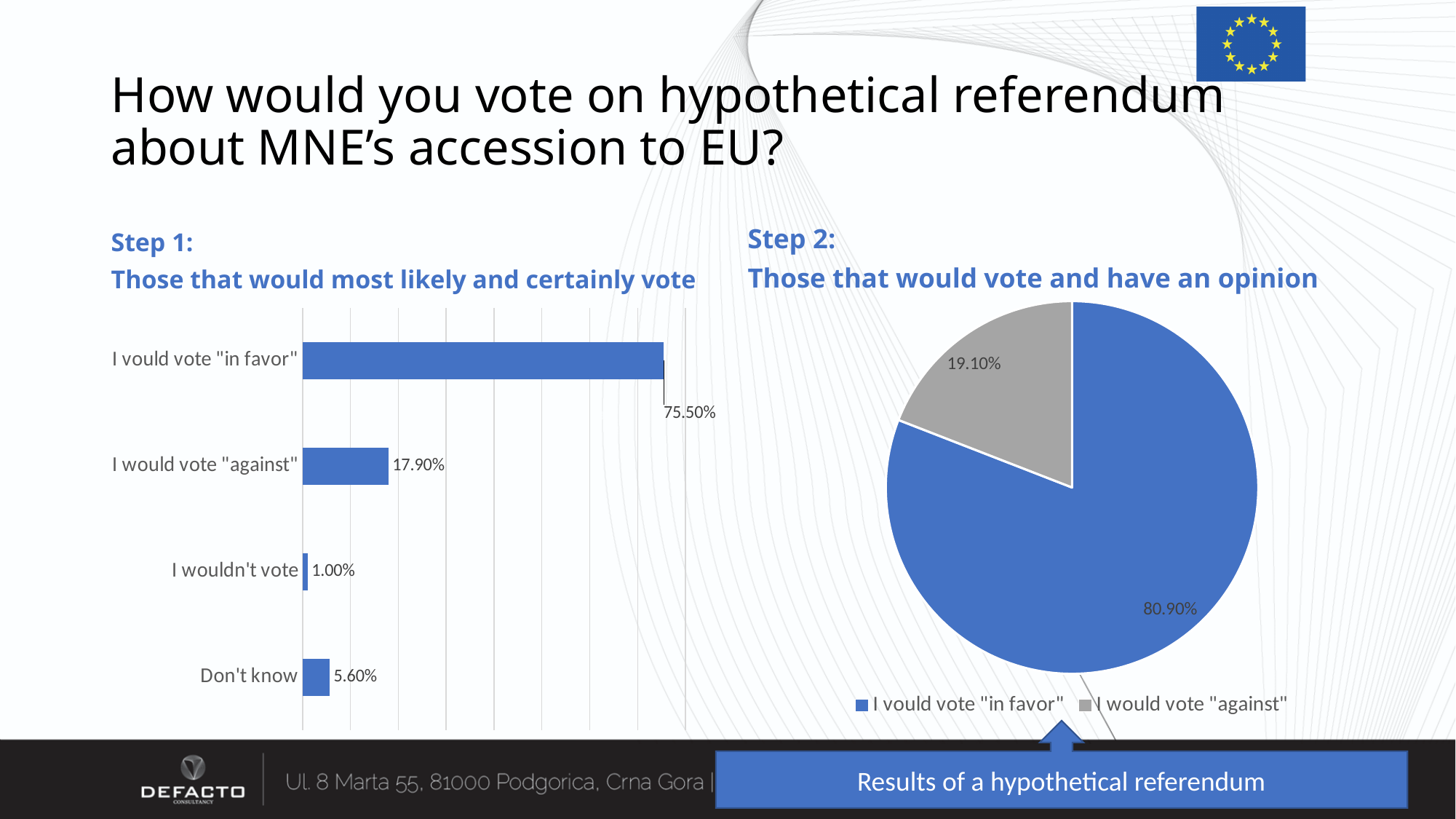
In the Step 2 pie chart, what share is "I vould vote 'in favor'"? 80.90% In the Step 1 bar chart, which category has the lowest value? I wouldn't vote What kind of chart is the Step 1 chart on the left? Bar chart In the Step 1 bar chart, what is the value for "I would vote 'against'"? 17.90% In the Step 2 pie chart, how many entries does the legend list? 2 In the Step 1 bar chart, how many categories are shown? 4 In the Step 1 bar chart, what is the value for "Don't know"? 5.60% In the Step 1 bar chart, what is the difference between "I would vote 'against'" and "Don't know"? 12.30% In the Step 2 pie chart, what share is "I would vote 'against'"? 19.10% In the Step 1 bar chart, which category has the highest value? I vould vote "in favor" In the Step 2 pie chart, what colour is the "I would vote 'against'" slice? Grey In the Step 1 bar chart, what is the value for "I vould vote 'in favor'"? 75.50%